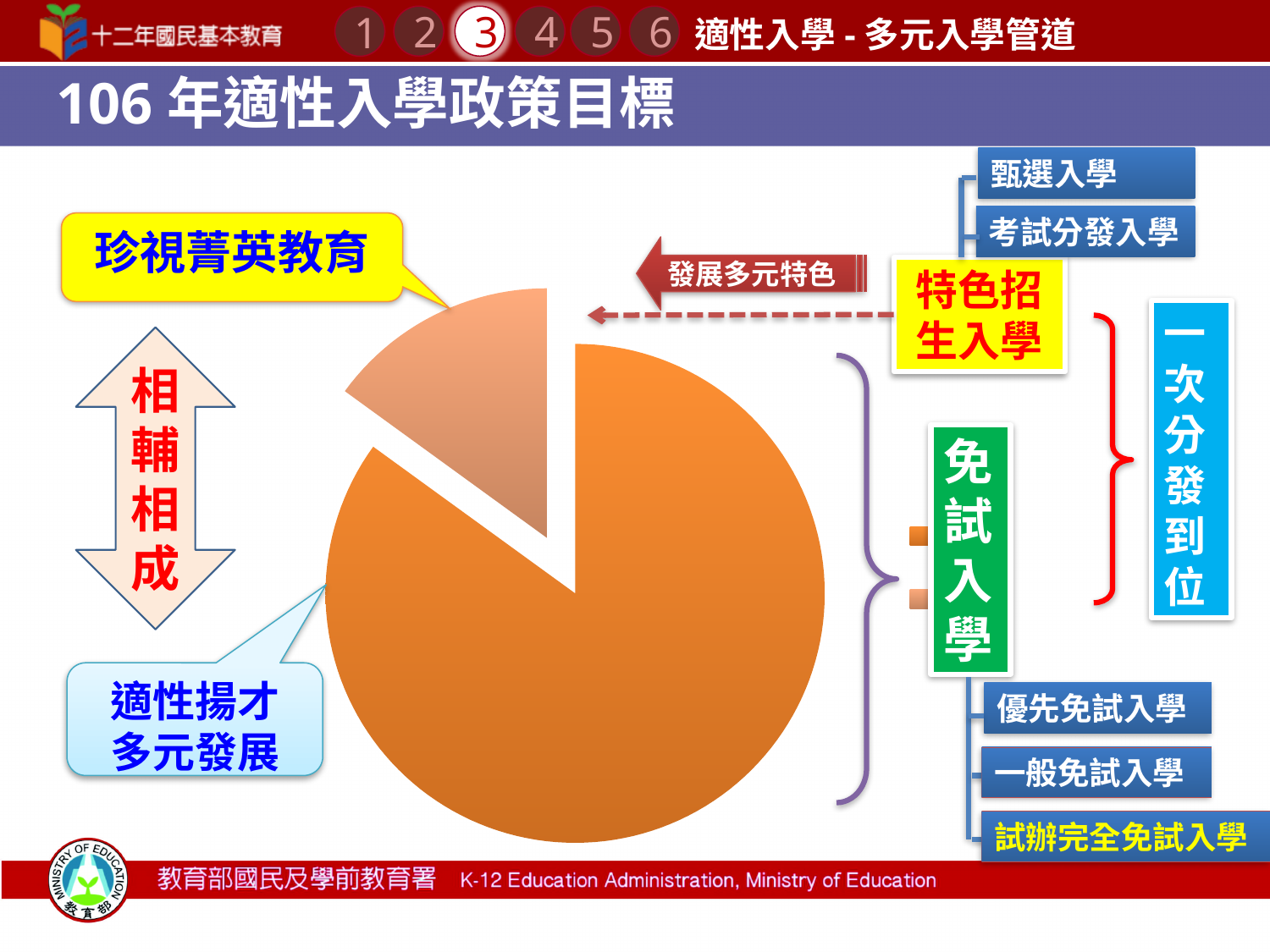
Which slice of the pie chart is larger, 免試入學 or 特色招生入學? 免試入學 What colour is the large 免試入學 slice of the pie chart? orange What kind of chart is shown on the slide? pie chart Which slice of the pie chart is pulled out (exploded) from the rest of the pie? 特色招生入學 Which category has the smallest slice in the pie chart? 特色招生入學 How many slices does the pie chart have? 2 Which category has the largest slice in the pie chart? 免試入學